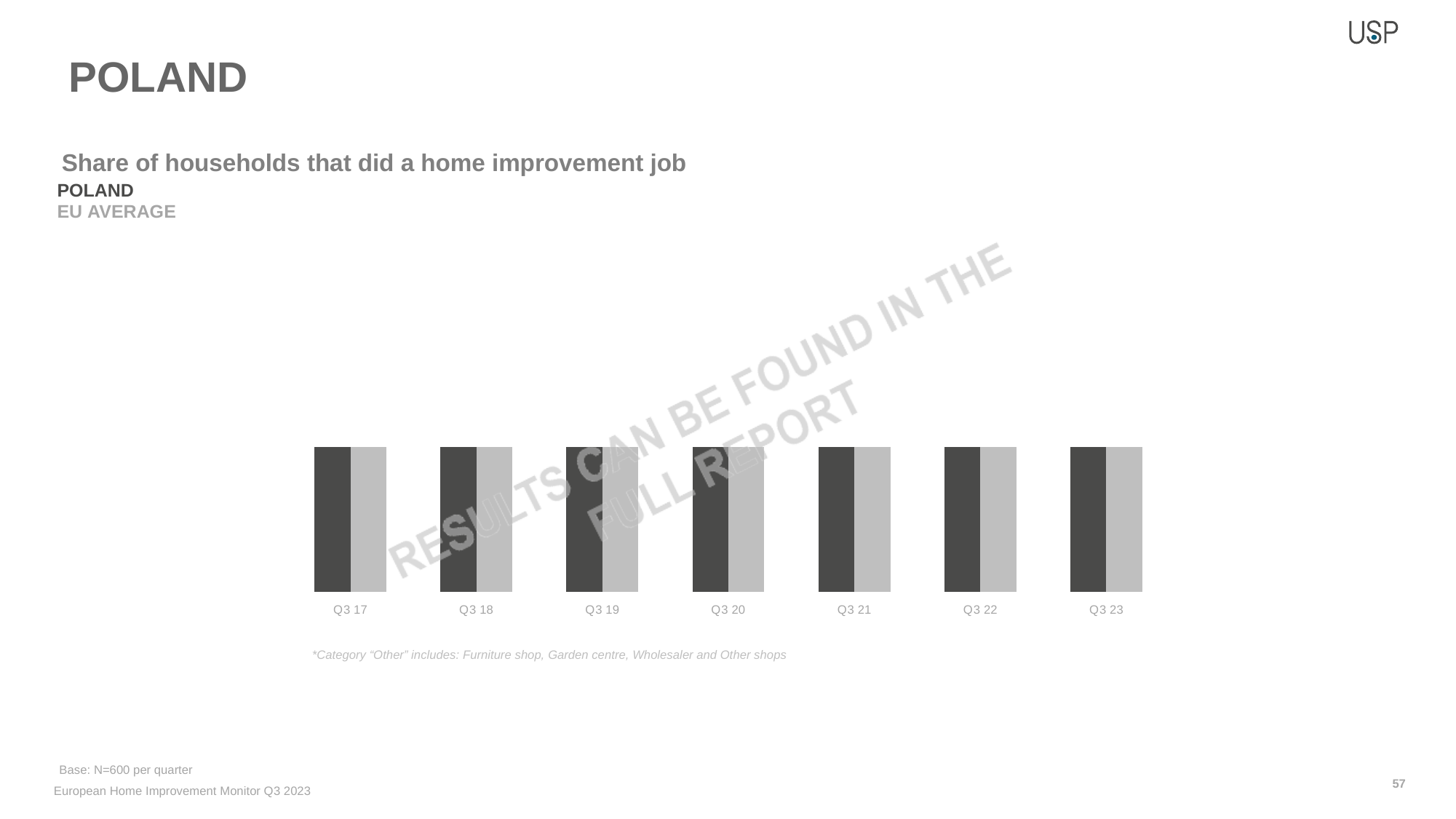
How many series does the chart's legend list? 2 Which two series are listed in the chart's legend? POLAND and EU AVERAGE What is the last quarter shown on the x axis of the chart? Q3 23 How many quarters are shown on the x axis of the chart? 7 What is the title of the chart? Share of households that did a home improvement job What is the first quarter shown on the x axis of the chart? Q3 17 What kind of chart is shown on the slide? bar chart